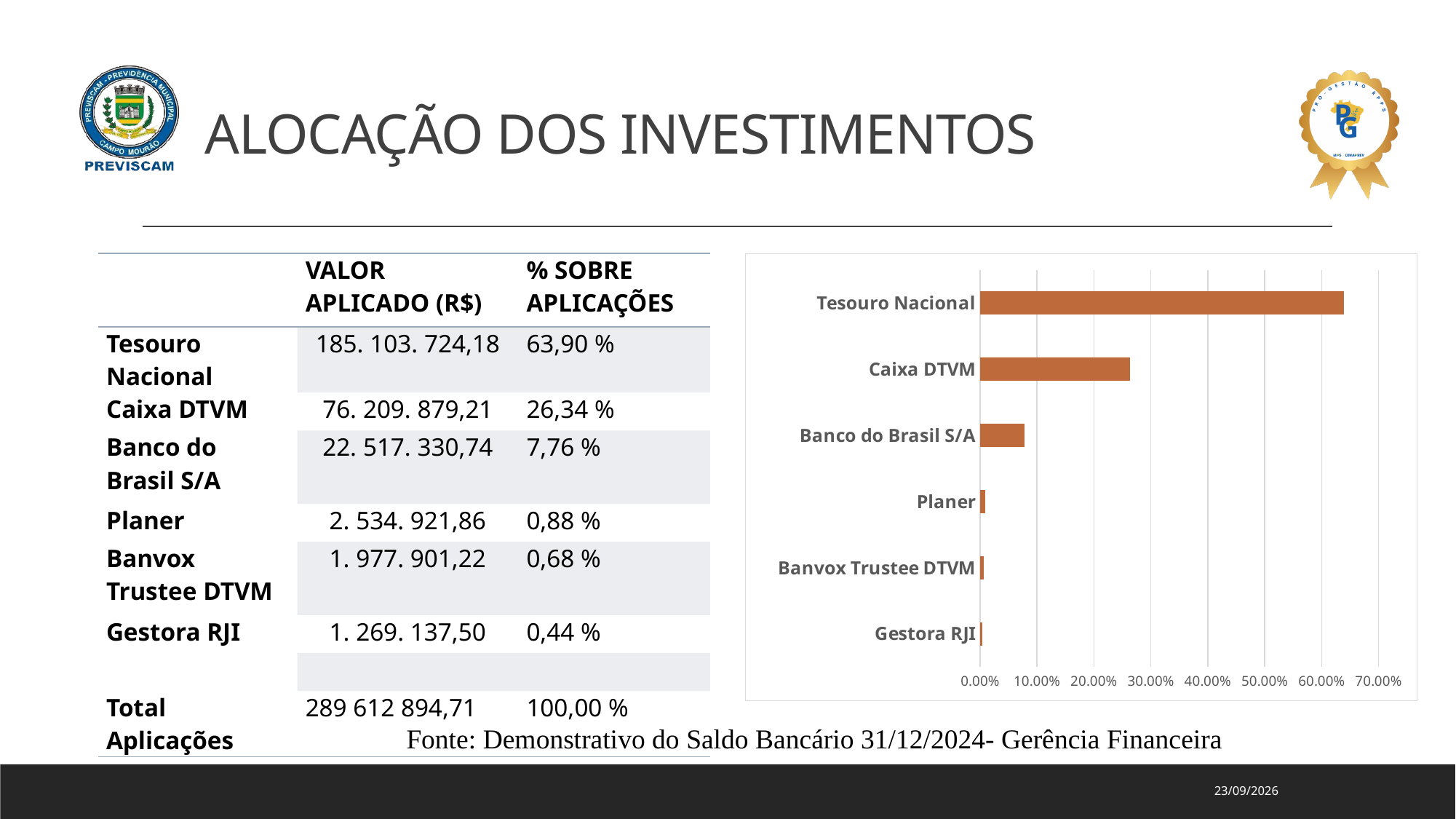
In the chart, is the value for Caixa DTVM greater or less than 30.00%? less What is the highest value shown on the chart's horizontal axis? 70.00% In the chart, is the value for Tesouro Nacional greater or less than 60.00%? greater In the chart, which is larger, the bar for Planer or the bar for Tesouro Nacional? Tesouro Nacional How many categories does the bar chart show? 6 In the chart, which is larger, the bar for Caixa DTVM or the bar for Banco do Brasil S/A? Caixa DTVM In the chart, is the value for Banco do Brasil S/A greater or less than 10.00%? less Which category has the shortest bar in the chart? Gestora RJI Which category has the longest bar in the chart? Tesouro Nacional What kind of chart is shown on the right of the slide? bar chart According to the table on the slide, what percentage of applications does Tesouro Nacional represent? 63,90 % According to the table on the slide, what percentage of applications does Planer represent? 0,88 %